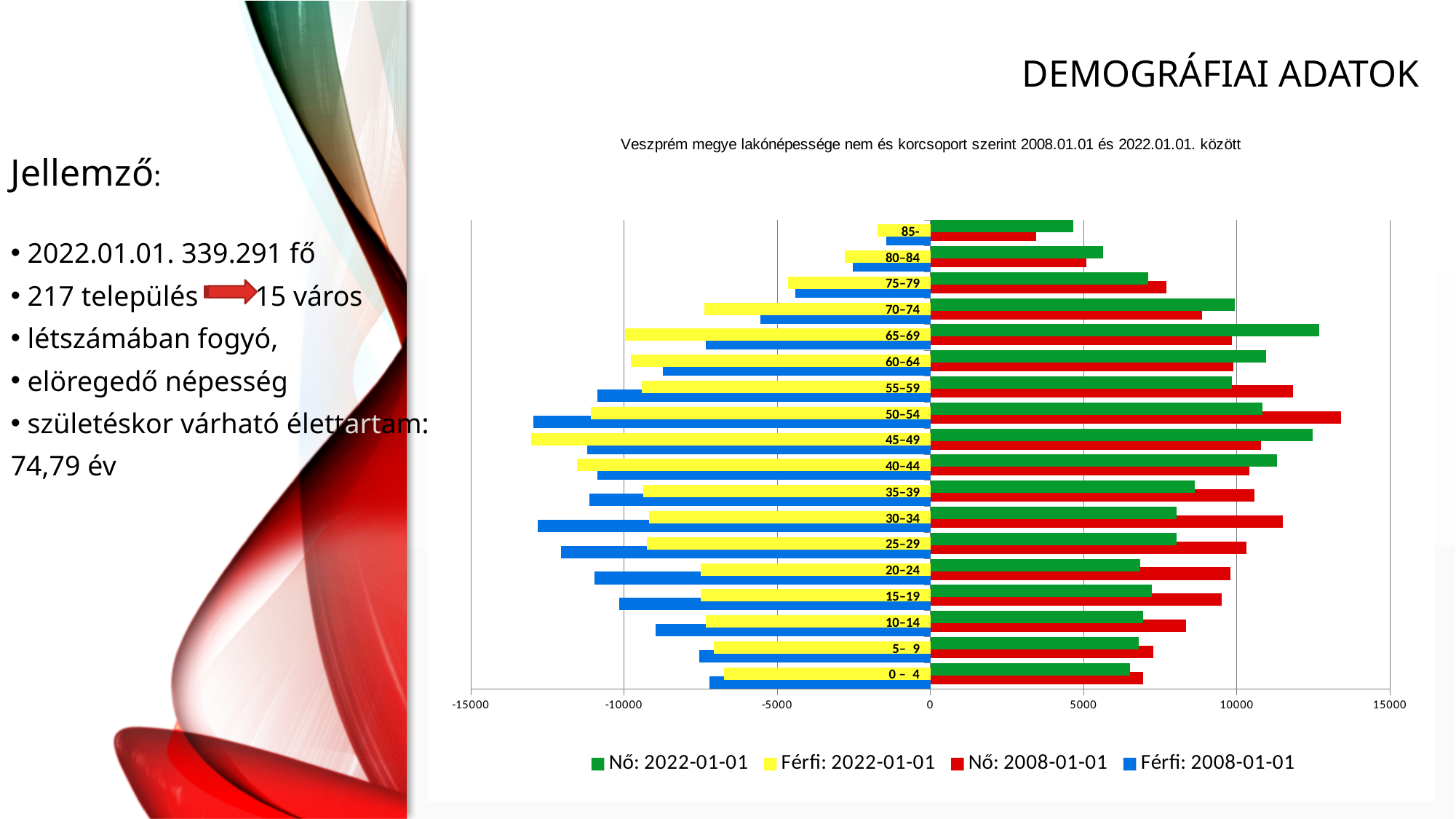
For the 30-34 age group, which is larger: the Nő: 2022-01-01 value or the Nő: 2008-01-01 value? Nő: 2008-01-01 For the 65-69 age group, which is larger: the Nő: 2022-01-01 value or the Nő: 2008-01-01 value? Nő: 2022-01-01 What kind of chart is shown on the slide? bar chart Which series is shown in green in the chart? Nő: 2022-01-01 Is the Nő: 2008-01-01 value for the 85- age group greater or less than 5000? less For which age group is the Nő: 2008-01-01 value lowest? 85- What is the title of the chart? Veszprém megye lakónépessége nem és korcsoport szerint 2008.01.01 és 2022.01.01. között How many age groups are shown on the chart? 18 How many series does the chart legend list? 4 For which age group is the Nő: 2008-01-01 value highest? 50-54 Is the Nő: 2022-01-01 value for the 65-69 age group greater or less than 10000? greater For which age group is the Nő: 2022-01-01 value highest? 65-69